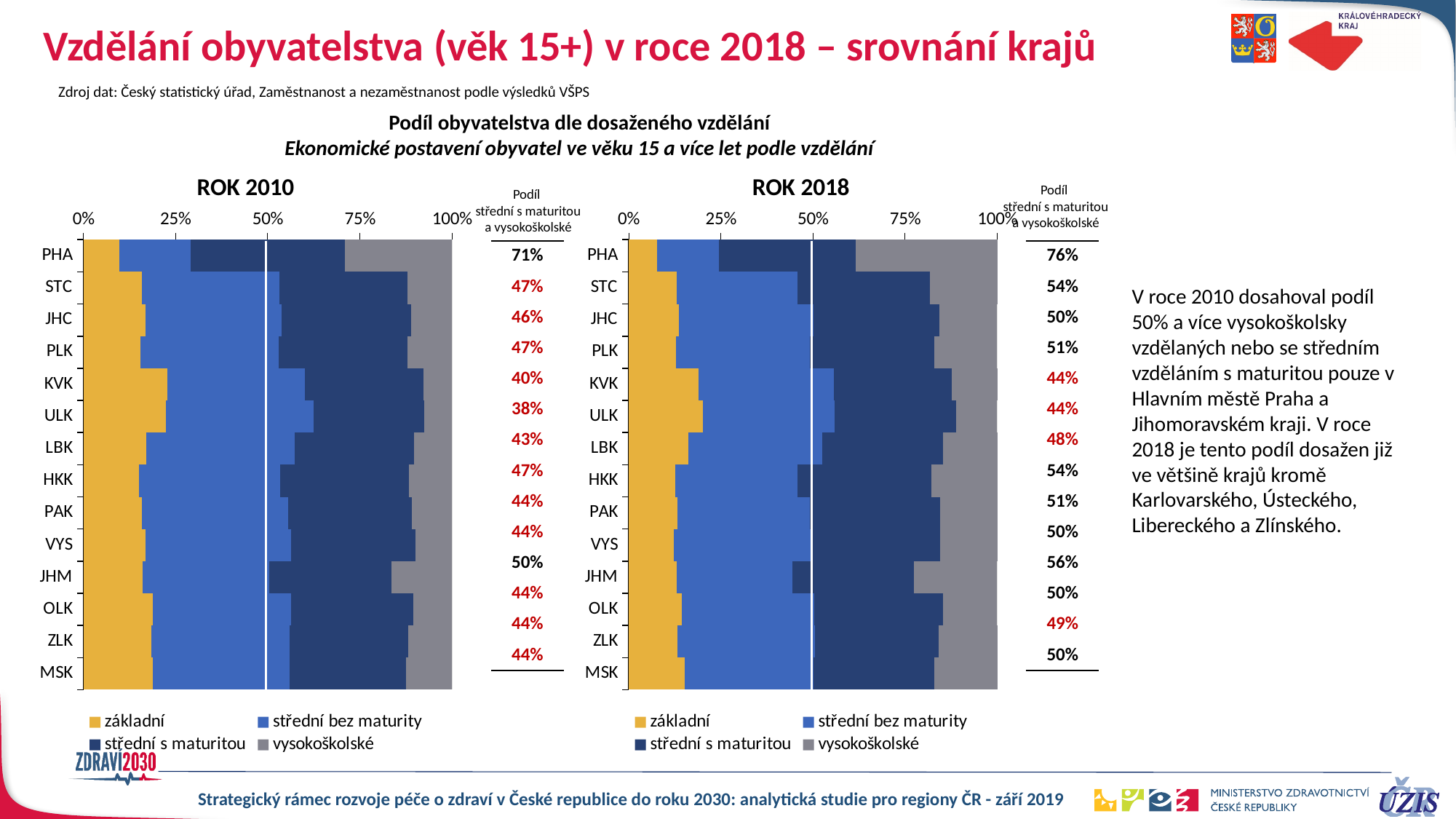
In the ROK 2018 chart, what is the printed share of 'střední s maturitou a vysokoškolské' for JHM? 56% By how many percentage points did the printed share for PHA change from the ROK 2010 chart to the ROK 2018 chart? 5 percentage points In the ROK 2010 chart, is the 'základní' segment for PHA greater or less than 25%? less What type of chart is the ROK 2018 chart? Stacked bar chart In the ROK 2010 chart, which region has the lowest printed share of 'střední s maturitou a vysokoškolské'? ULK In the ROK 2010 chart, what is the printed share of 'střední s maturitou a vysokoškolské' for PHA? 71% How many series does the legend of the ROK 2010 chart list? 4 In the ROK 2010 chart, what is the difference between the printed shares for PHA and ULK? 33 percentage points In the ROK 2018 chart, which region has the highest printed share of 'střední s maturitou a vysokoškolské'? PHA How many regions are shown in the ROK 2018 chart? 14 In the ROK 2018 chart, what is the printed share of 'střední s maturitou a vysokoškolské' for ULK? 44% In the ROK 2018 chart, which has the larger printed share: STC or JHC? STC